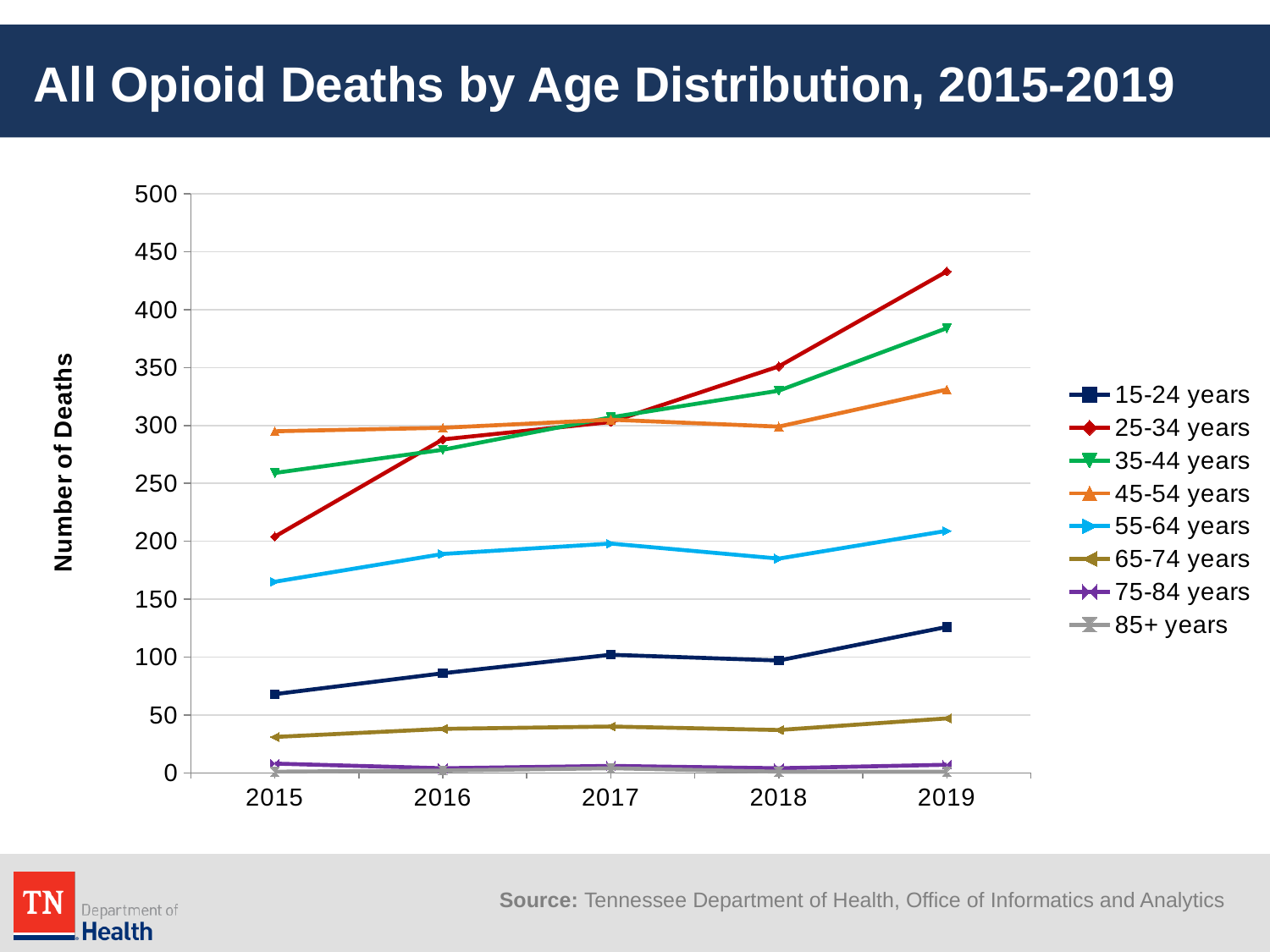
In 2019, which had more opioid deaths: 35-44 years or 45-54 years? 35-44 years How many age groups does the legend list? 8 Is the value for 25-34 years in 2019 greater or less than 400? greater Is the value for 15-24 years in 2015 greater or less than 100? less What is the label on the vertical axis? Number of Deaths How many years are plotted along the x axis? 5 Which age group had the highest number of opioid deaths in 2015? 45-54 years Do opioid deaths for the 25-34 years group rise or fall from 2015 to 2019? Rise In 2015, which had more opioid deaths: 25-34 years or 35-44 years? 35-44 years Is the value for 55-64 years in 2019 greater or less than 250? less What kind of chart is shown on the slide? Line chart Which age group had the highest number of opioid deaths in 2019? 25-34 years